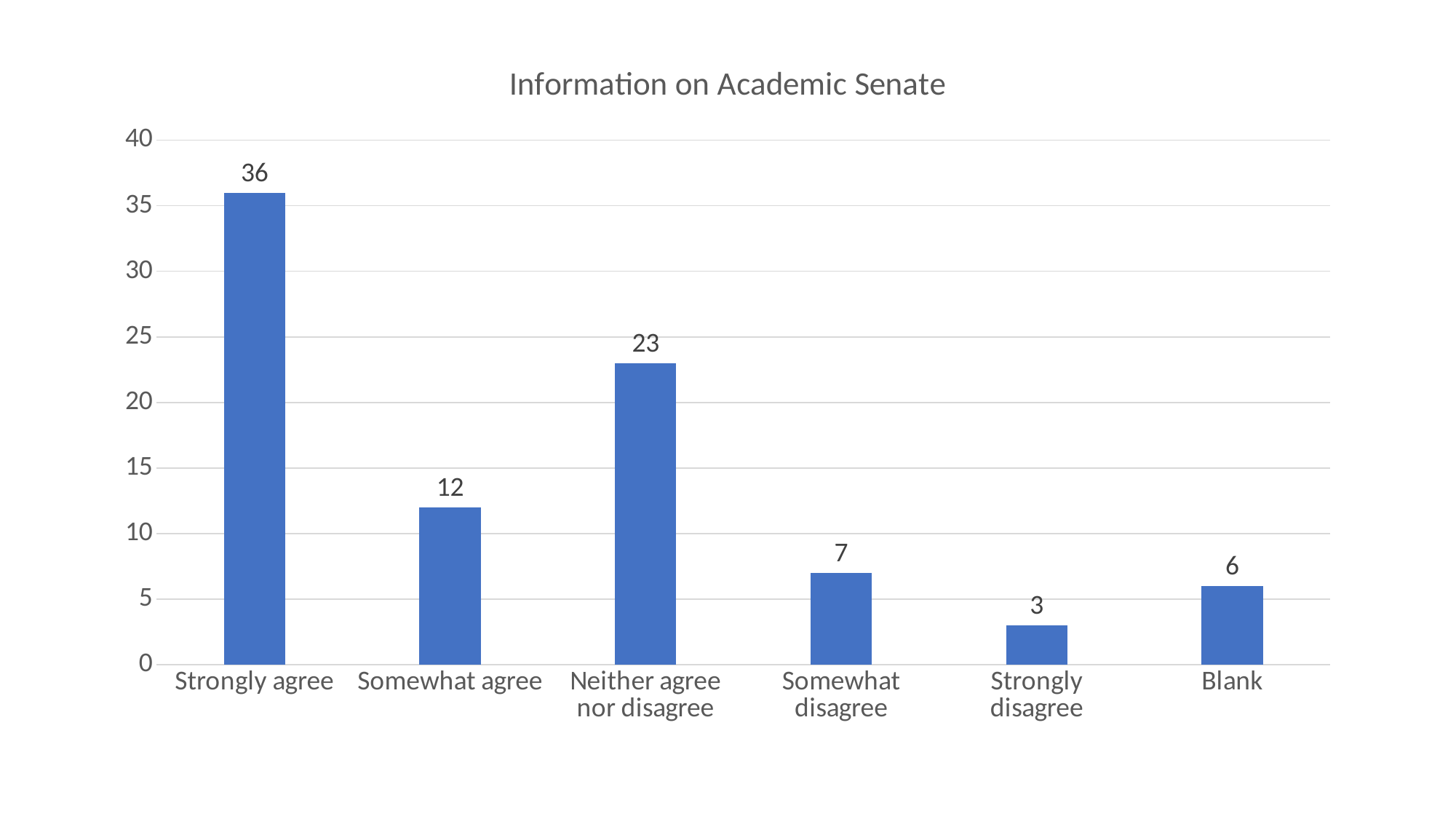
Which category has the highest value? Strongly agree Which is larger, the value for Somewhat agree or the value for Neither agree nor disagree? Neither agree nor disagree What is the title of the chart? Information on Academic Senate What is the value for Strongly agree? 36 What is the value for Neither agree nor disagree? 23 What kind of chart is shown on the slide? bar chart What is the value for Blank? 6 What is the difference between the values for Somewhat disagree and Strongly disagree? 4 Is the value for Somewhat agree greater or less than 10? greater Which category has the lowest value? Strongly disagree How many categories are shown on the x axis? 6 What is the difference between the values for Strongly agree and Somewhat agree? 24